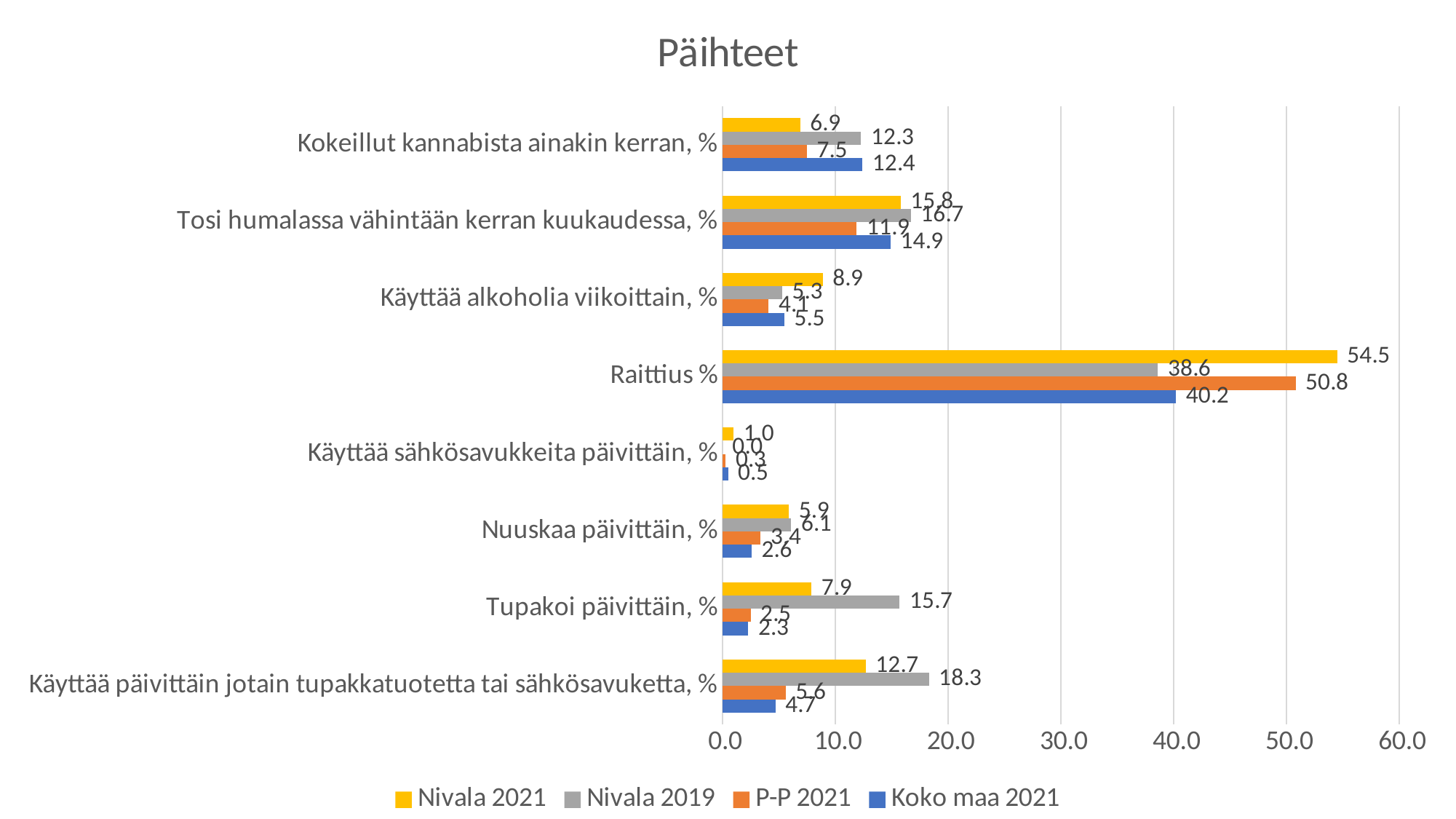
How many categories are shown on the chart? 8 What is the P-P 2021 value for Tosi humalassa vähintään kerran kuukaudessa, %? 11.9 What is the difference between the Nivala 2019 and Nivala 2021 values for Käyttää päivittäin jotain tupakkatuotetta tai sähkösavuketta, %? 5.6 What is the Nivala 2021 value for Raittius %? 54.5 What is the Nivala 2019 value for Tupakoi päivittäin, %? 15.7 For Raittius %, which is larger: the P-P 2021 value or the Koko maa 2021 value? P-P 2021 Which category has the lowest Koko maa 2021 value? Käyttää sähkösavukkeita päivittäin, % Which category has the highest Nivala 2021 value? Raittius % What is the Koko maa 2021 value for Kokeillut kannabista ainakin kerran, %? 12.4 What type of chart is shown on the slide? Bar chart Is the Nivala 2019 value for Raittius % greater or less than 40.0? less How many series does the legend list? 4